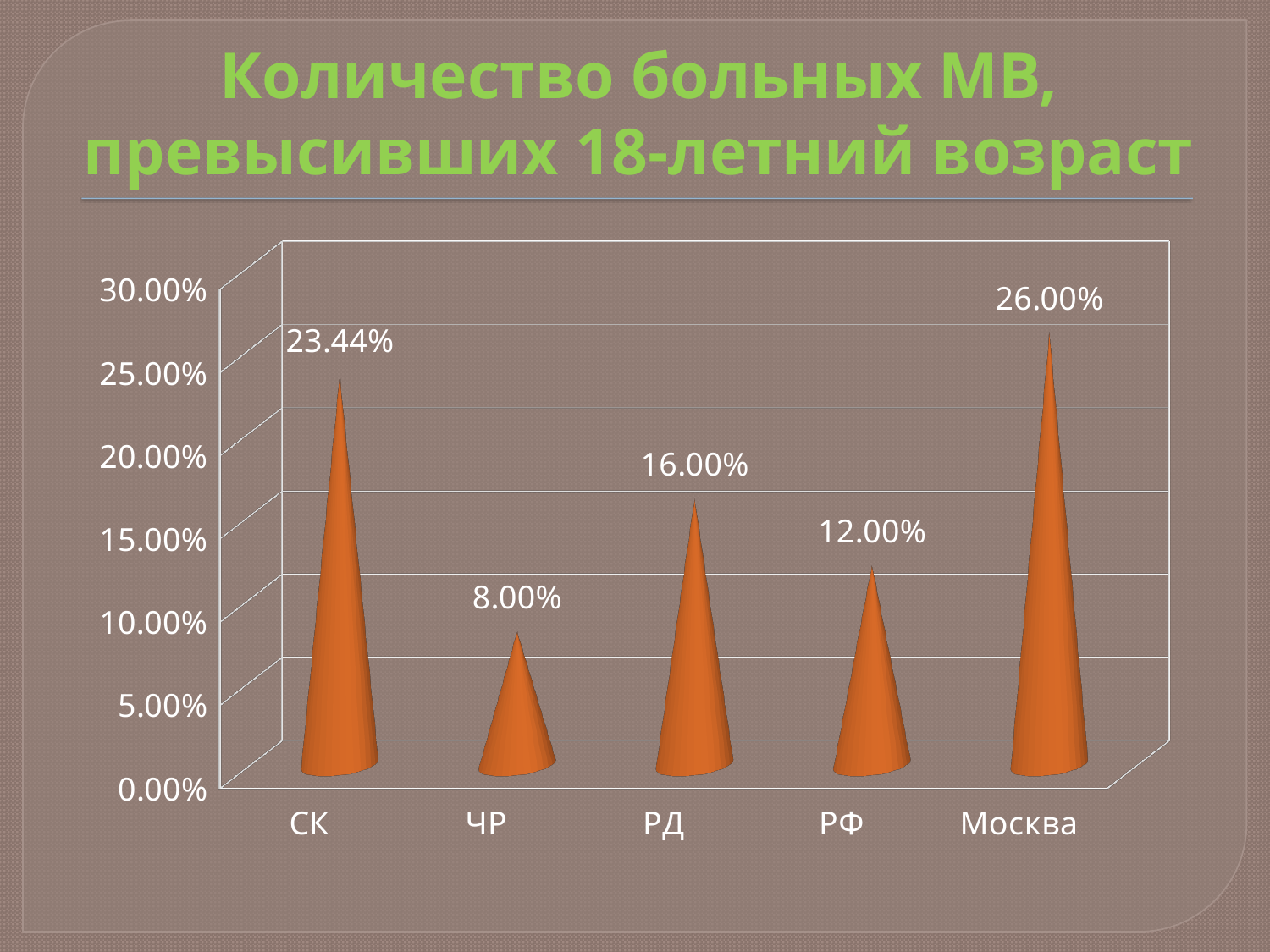
Which category has the lowest value? ЧР Which is larger, the value for РД or the value for РФ? РД What kind of chart is shown on the slide? bar chart What is the value for СК? 23.44% What is the value for ЧР? 8.00% Is the value for РФ greater or less than 15.00%? less What is the difference between the values for Москва and СК? 2.56% What is the difference between the values for РД and РФ? 4.00% How many categories are shown on the x axis? 5 Which category has the highest value? Москва What is the value for Москва? 26.00% What is the title of the chart? Количество больных МВ, превысивших 18-летний возраст